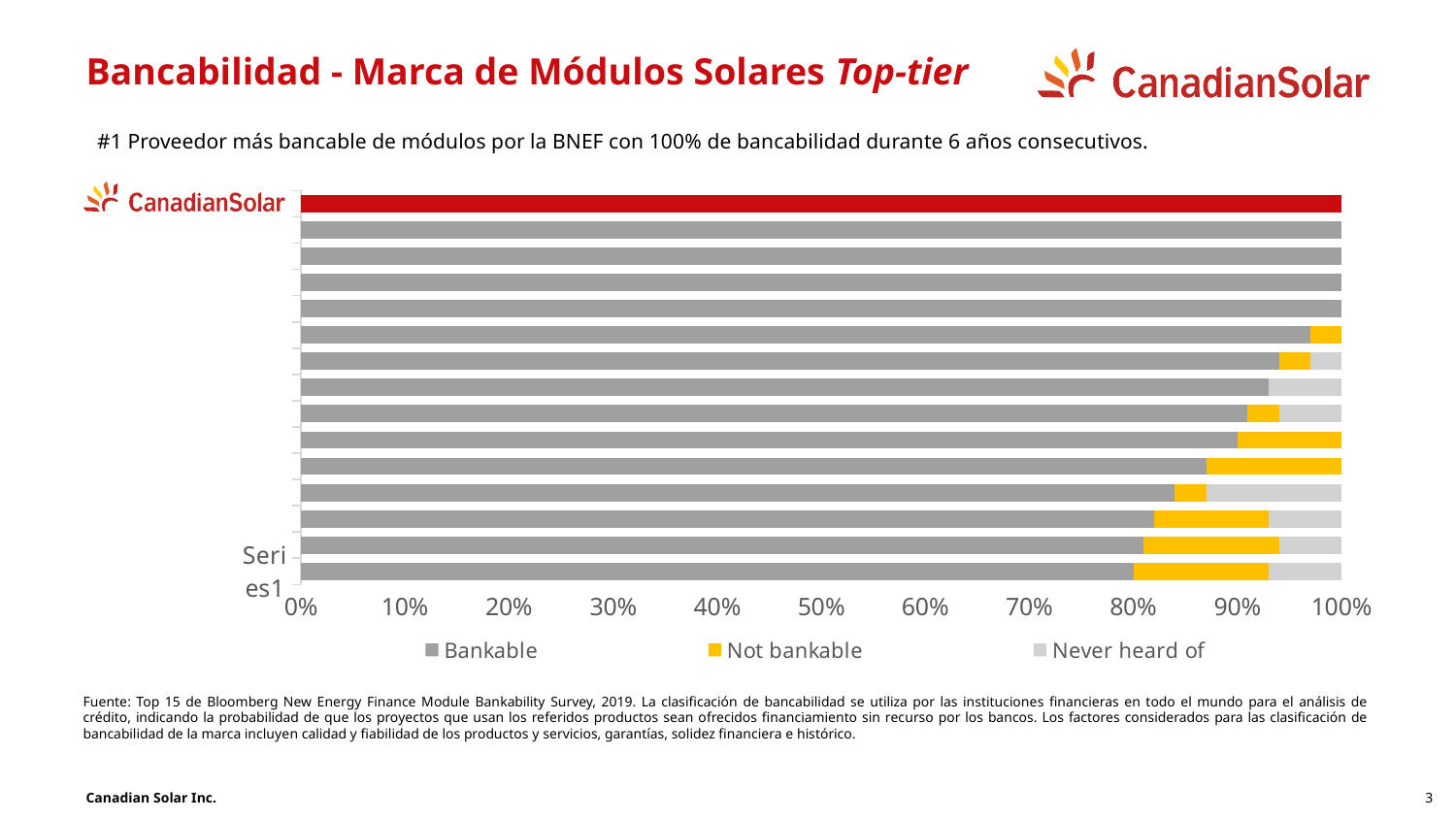
Is the Bankable value for the bar labelled Series1 greater or less than 90%? less How many series does the chart legend list? 3 How many bars are plotted in the chart? 15 What are the three series named in the chart legend? Bankable, Not bankable, Never heard of Is the Bankable value for the bar labelled Series1 greater or less than 70%? greater Which brand's bar is highlighted in red at the top of the chart? Canadian Solar What is the maximum value shown on the x axis? 100% Is the Bankable value for the Canadian Solar bar greater or less than 90%? greater What kind of chart is shown on the slide? Stacked bar chart What bankability percentage does the slide state for Canadian Solar? 100% Going from the top bar to the bottom bar, does the Bankable portion increase or decrease? decrease